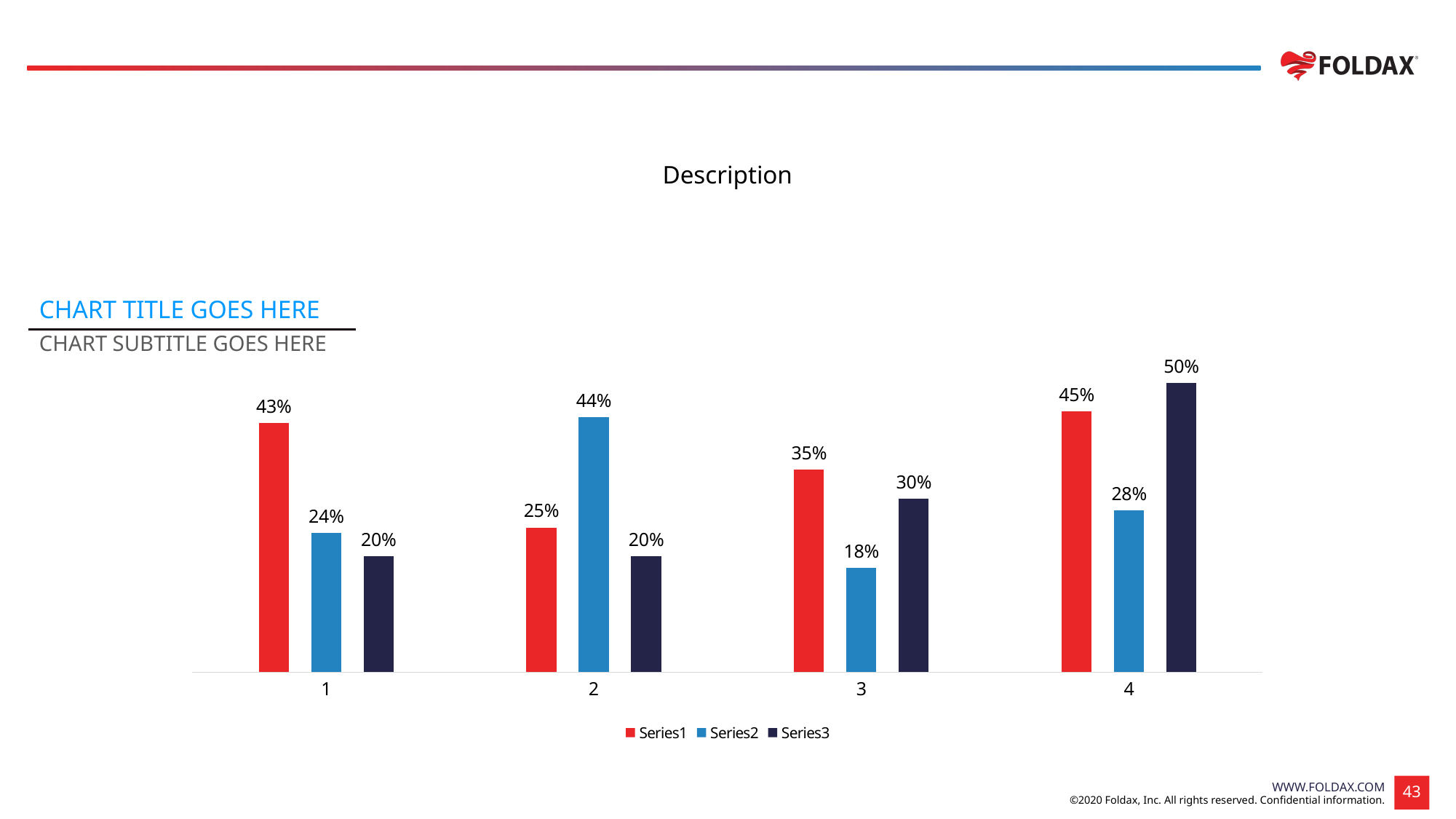
How many series does the legend list? 3 What is the value of Series1 for category 1? 43% What is the value of Series2 for category 2? 44% What is the value of Series3 for category 3? 30% What kind of chart is shown on the slide? Bar chart Which is larger for category 2: Series1 or Series2? Series2 How many categories are shown on the x axis? 4 Which category has the highest Series3 value? 4 What is the difference between Series1 and Series2 for category 3? 17% What is the chart's title? CHART TITLE GOES HERE What is the value of Series2 for category 4? 28% Which category has the lowest Series2 value? 3